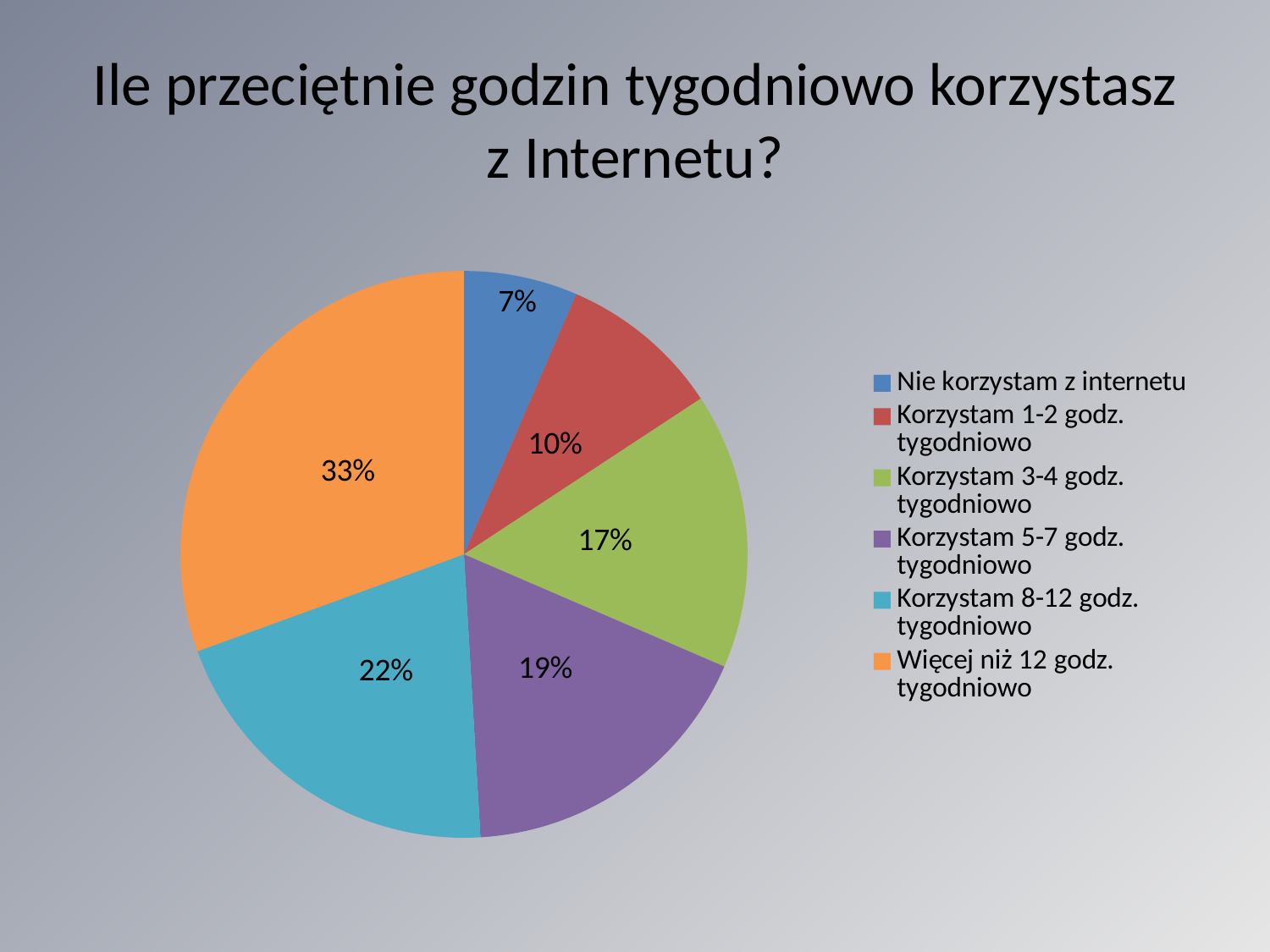
What is the value for "Korzystam 5-7 godz. tygodniowo"? 19% Which is larger, the value for "Korzystam 3-4 godz. tygodniowo" or "Korzystam 5-7 godz. tygodniowo"? Korzystam 5-7 godz. tygodniowo What kind of chart is shown on the slide? pie chart What is the value for "Korzystam 3-4 godz. tygodniowo"? 17% How many categories does the pie chart have? 6 What is the difference between the values for "Więcej niż 12 godz. tygodniowo" and "Korzystam 8-12 godz. tygodniowo"? 11% Which category has the largest slice of the pie? Więcej niż 12 godz. tygodniowo What is the value for "Korzystam 1-2 godz. tygodniowo"? 10% What is the value for "Korzystam 8-12 godz. tygodniowo"? 22% Which category has the smallest slice of the pie? Nie korzystam z internetu What colour is the slice for "Więcej niż 12 godz. tygodniowo"? orange What share of the pie is labelled "Nie korzystam z internetu"? 7%